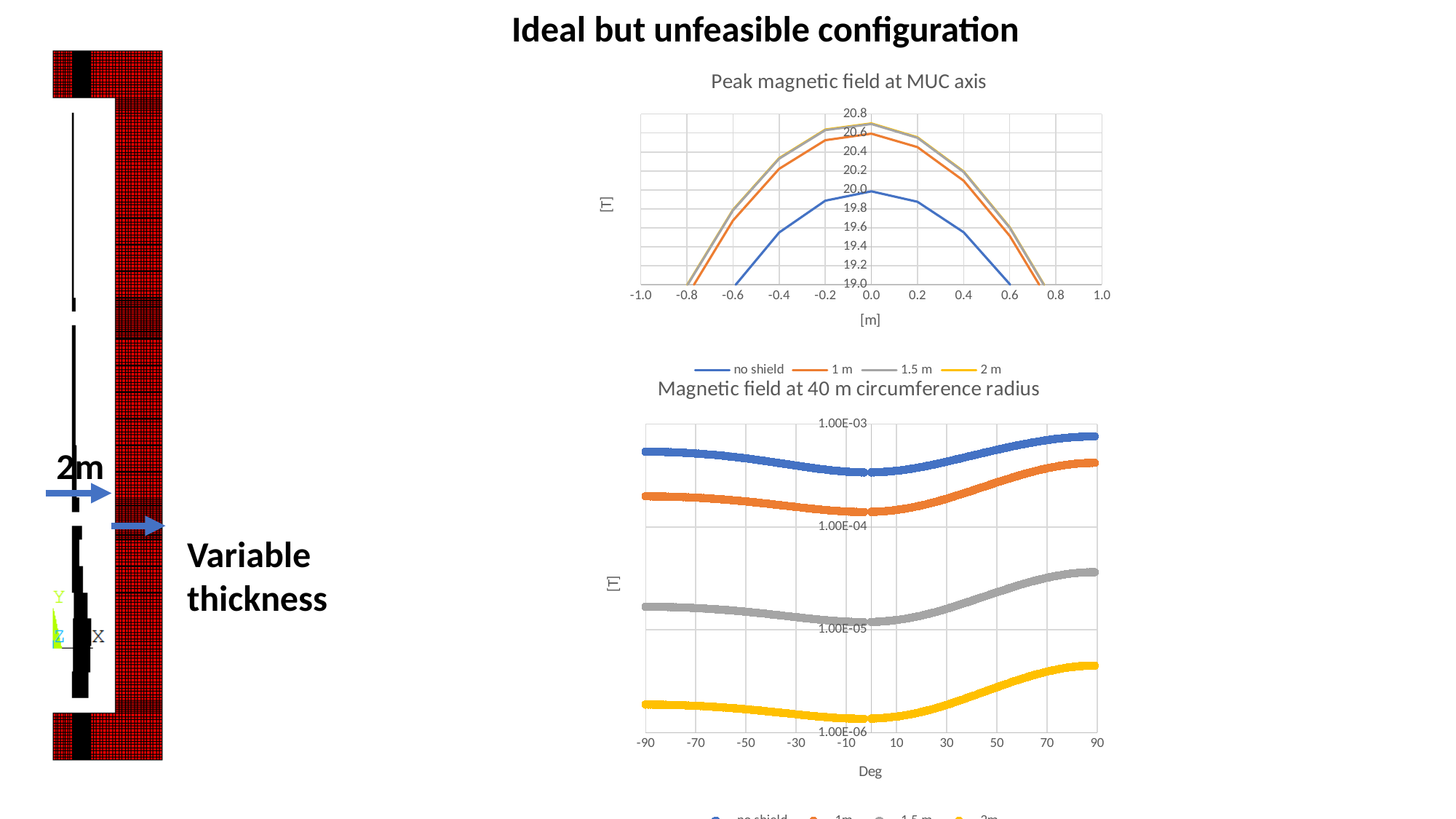
What kind of chart is the 'Peak magnetic field at MUC axis' chart? line chart In the 'Peak magnetic field at MUC axis' chart, do the values rise or fall as the x axis goes from -0.8 m to 0.0 m? rise In the 'Magnetic field at 40 m circumference radius' chart, do the values rise or fall as the x axis goes from 0 to 90 degrees? rise In the 'Peak magnetic field at MUC axis' chart, is the value of the '1 m' series at 0.0 m greater or less than 20.4? greater In the 'Peak magnetic field at MUC axis' chart, which series has the lowest peak value at 0.0 m? no shield What is the title of the top chart on the slide? Peak magnetic field at MUC axis How many series does the legend of the 'Peak magnetic field at MUC axis' chart list? 4 In the 'Magnetic field at 40 m circumference radius' chart, is the value of the 'no shield' series at 90 degrees greater or less than 1.00E-03? less In the 'Magnetic field at 40 m circumference radius' chart, which series has the lowest values? 2 m In the 'Peak magnetic field at MUC axis' chart, is the value of the 'no shield' series at -0.4 m greater or less than 19.8? less What is the title of the bottom chart on the slide? Magnetic field at 40 m circumference radius In the 'Magnetic field at 40 m circumference radius' chart, which series has the highest values? no shield